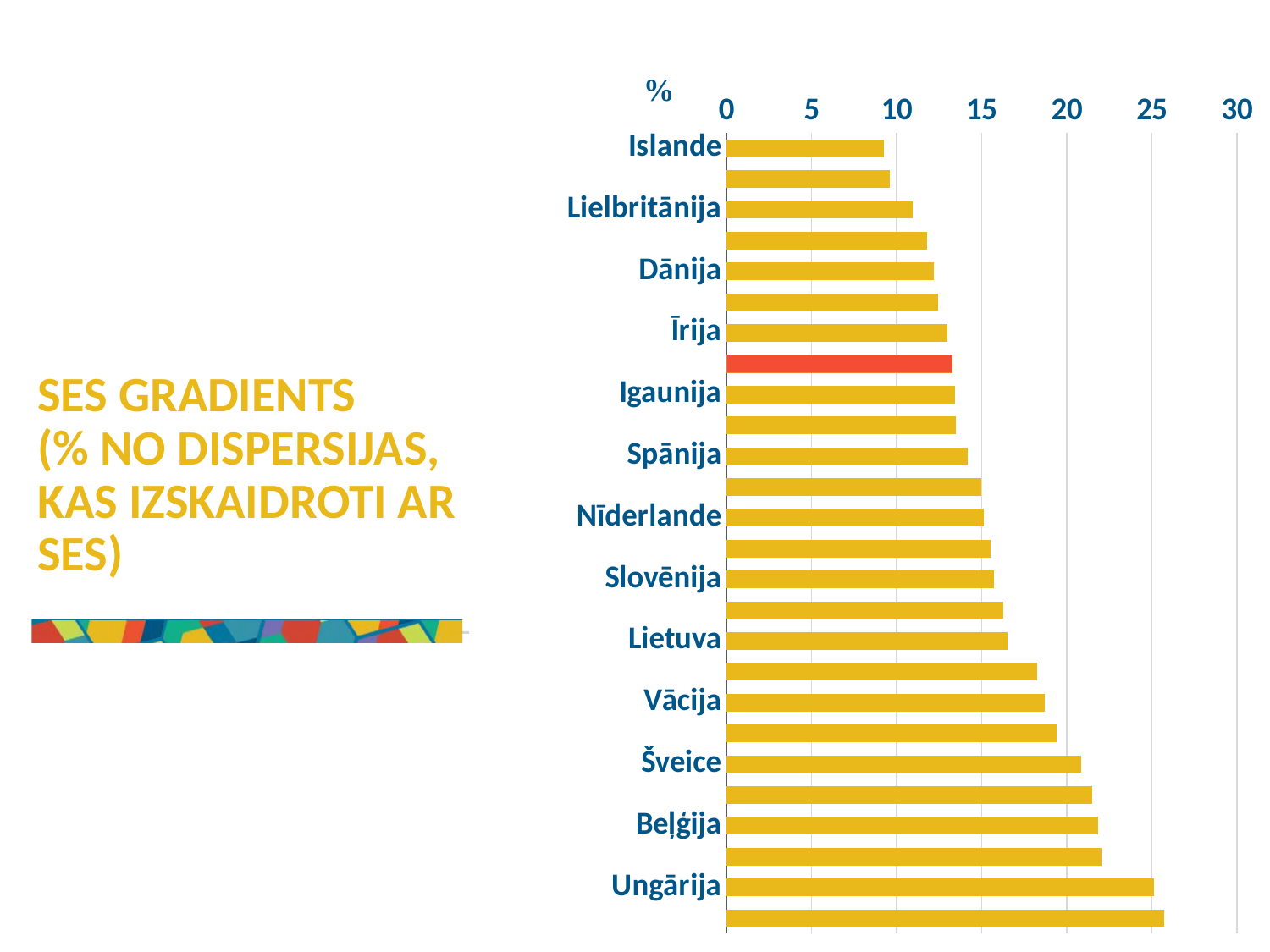
Is the value for Islande greater or less than 10? less Is the value for Beļģija greater or less than 20? greater What colour is the single highlighted bar that differs from the others? red Do the bar values increase or decrease going from the top of the chart to the bottom? increase Which has the larger value, Vācija or Dānija? Vācija What kind of chart is shown on the slide? bar chart Is the value for Lietuva greater or less than 15? greater Which labelled country has the highest value in the chart? Ungārija Which labelled country has the lowest value in the chart? Islande